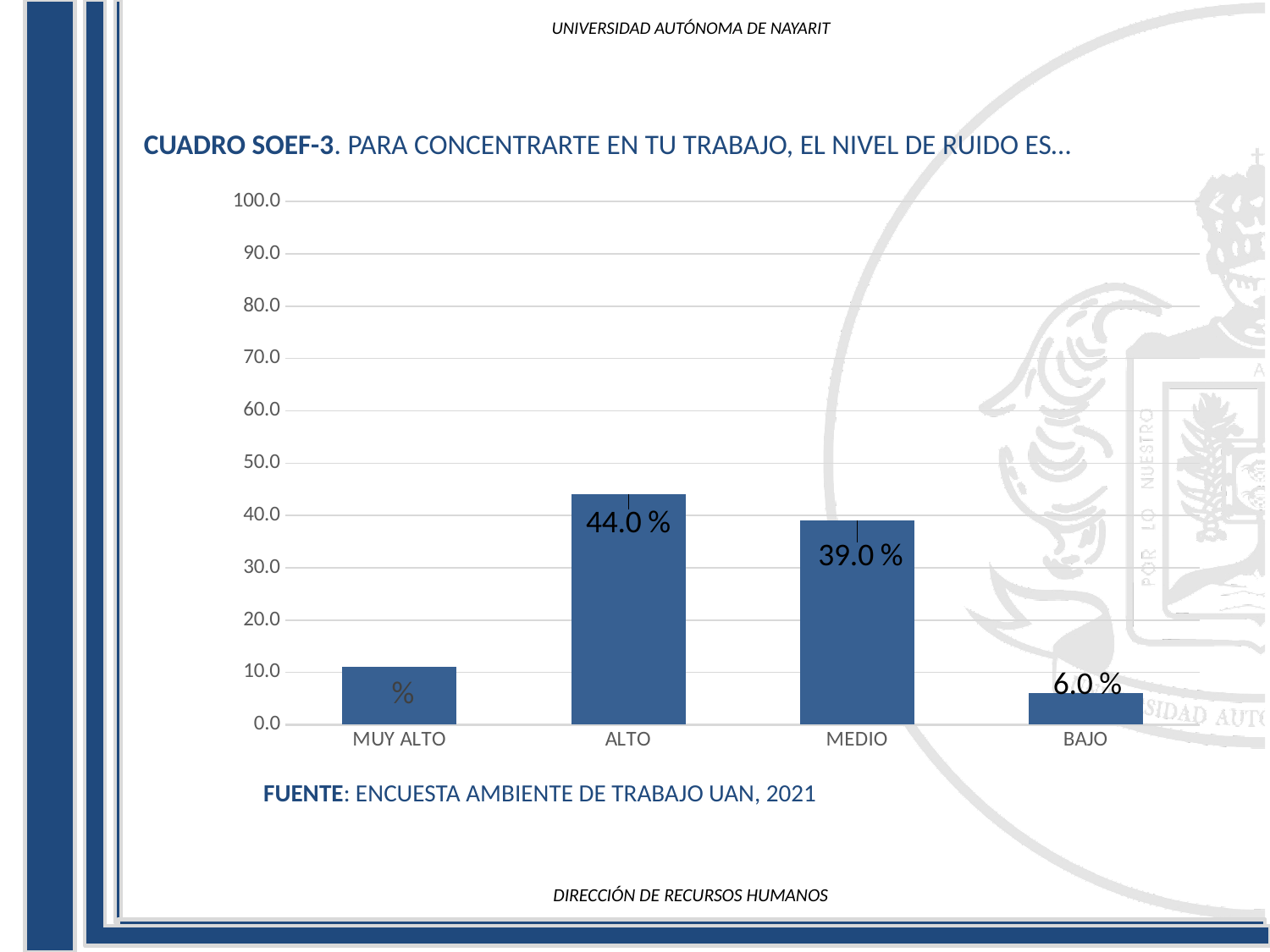
What kind of chart is shown on the slide? Bar chart What source is cited below the chart? ENCUESTA AMBIENTE DE TRABAJO UAN, 2021 Is the value for MUY ALTO greater or less than 20.0? less What is the value for MEDIO? 39.0 % How many categories are shown on the x axis? 4 Which is larger, the value for MEDIO or the value for BAJO? MEDIO What is the value for ALTO? 44.0 % Which category has the highest value? ALTO What is the value for BAJO? 6.0 % What is the difference between the values for ALTO and MEDIO? 5.0 % What is the difference between the values for ALTO and BAJO? 38.0 % Which category has the lowest value? BAJO